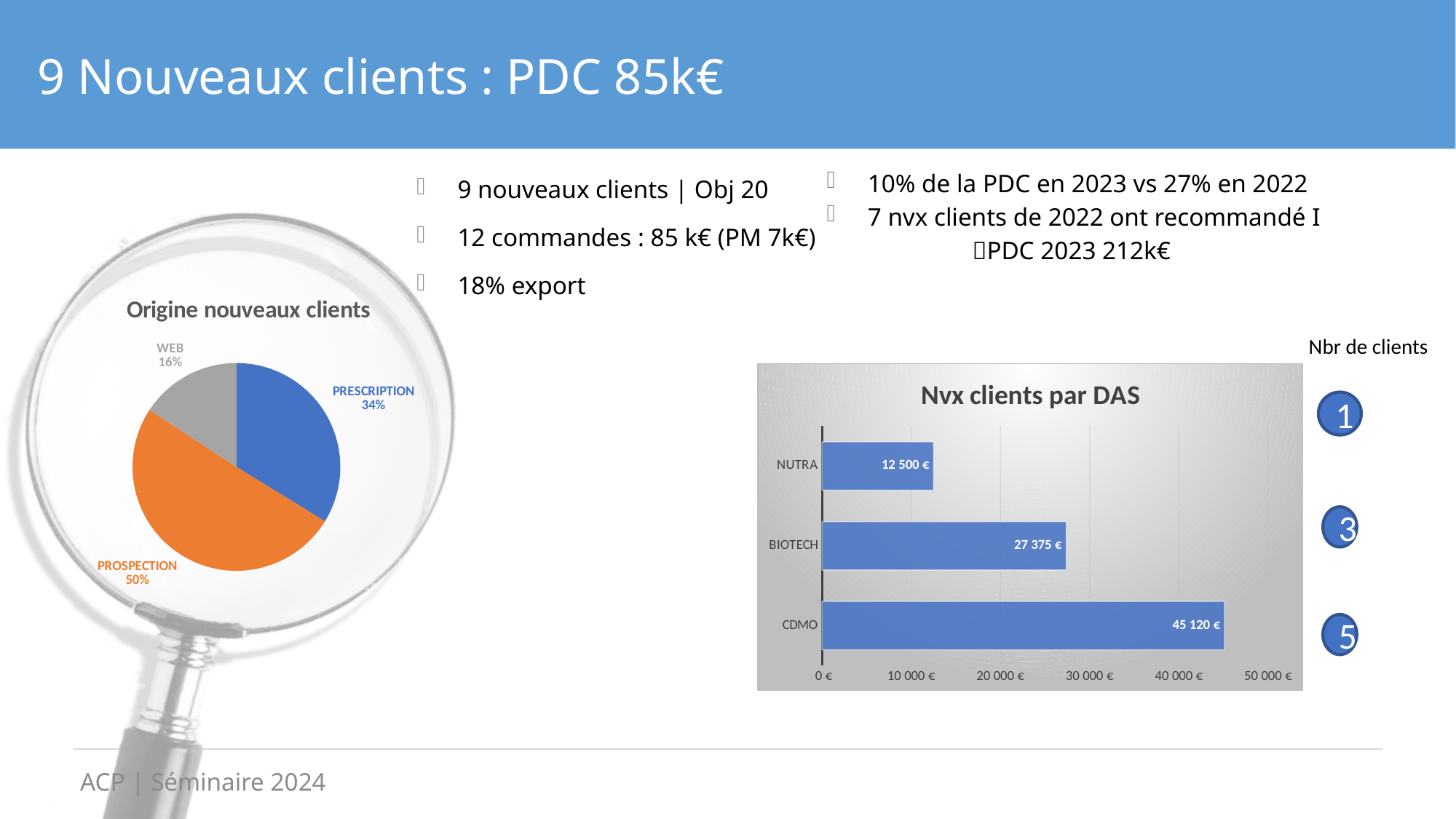
In the 'Nvx clients par DAS' chart, what is the difference between CDMO and NUTRA? 32 620 € How many slices does the 'Origine nouveaux clients' pie chart have? 3 What kind of chart is 'Nvx clients par DAS'? Bar chart In the 'Nvx clients par DAS' chart, what is the value for BIOTECH? 27 375 € What kind of chart is 'Origine nouveaux clients'? Pie chart In the 'Nvx clients par DAS' chart, is the value for BIOTECH greater or less than 30 000 €? less In the 'Origine nouveaux clients' chart, which origin has the smallest share? WEB In the 'Nvx clients par DAS' chart, which DAS has the highest value? CDMO In the 'Origine nouveaux clients' chart, what share of new clients came from PROSPECTION? 50% In the 'Origine nouveaux clients' chart, what share of new clients came from WEB? 16% In the 'Origine nouveaux clients' chart, which origin has the largest share? PROSPECTION In the 'Nvx clients par DAS' chart, what is the value for NUTRA? 12 500 €